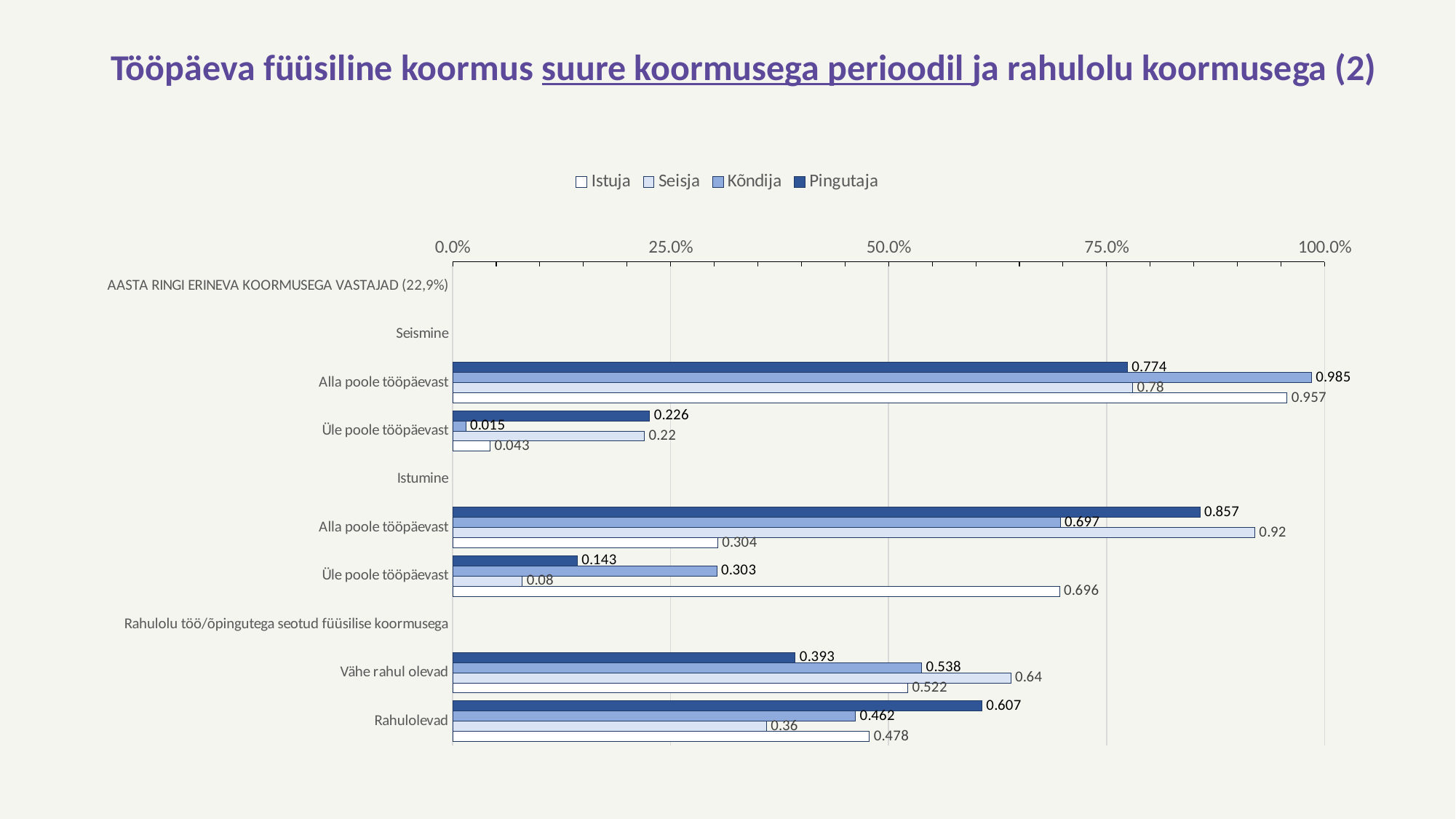
What kind of chart is shown on the slide? bar chart Which is larger for 'Vähe rahul olevad': the Kõndija value or the Istuja value? Kõndija Which series has the highest value for 'Alla poole tööpäevast' under Istumine? Seisja How many series does the legend list? 4 What is the Istuja value for 'Üle poole tööpäevast' under Istumine? 0.696 What is the difference between the Pingutaja and Kõndija values for 'Rahulolevad'? 0.145 Which series has the lowest value for 'Üle poole tööpäevast' under Seismine? Kõndija What is the Kõndija value for 'Alla poole tööpäevast' under Seismine? 0.985 Which series is shown with the darkest blue bars in the legend? Pingutaja What is the Pingutaja value for 'Rahulolevad'? 0.607 What is the Seisja value for 'Vähe rahul olevad'? 0.64 Is the Pingutaja value for 'Alla poole tööpäevast' under Seismine greater or less than 75.0%? greater